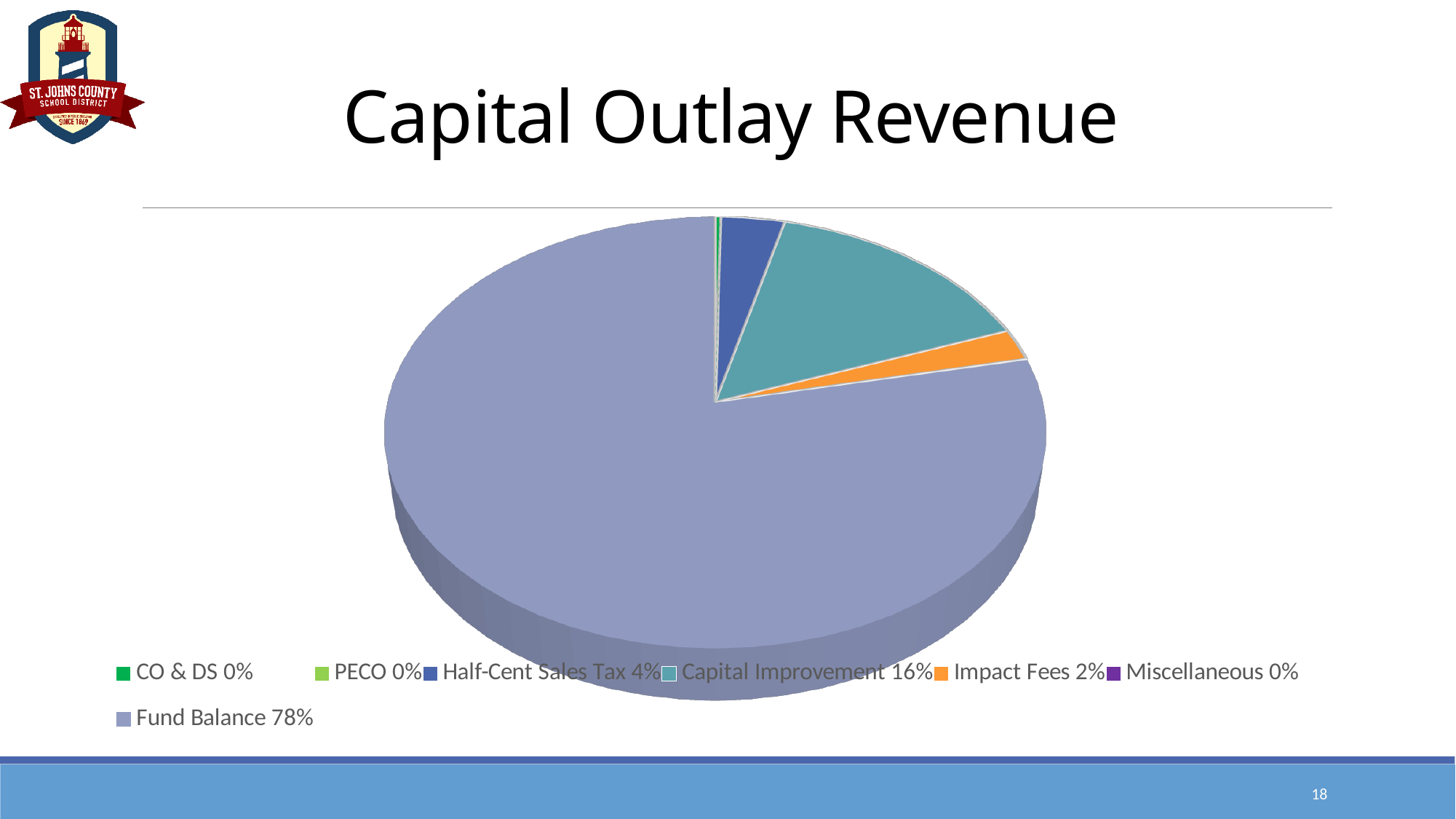
What is the difference in percentage points between Fund Balance and Capital Improvement? 62 What type of chart is shown on the slide? Pie chart What percentage is shown for PECO? 0% What percentage is shown for Impact Fees? 2% What share of Capital Outlay Revenue is Fund Balance? 78% How many categories does the legend list? 7 Which is larger, Half-Cent Sales Tax or Impact Fees? Half-Cent Sales Tax Which category has the largest share of the pie? Fund Balance What colour is the Impact Fees slice? Orange What is the title of the chart? Capital Outlay Revenue What percentage is shown for Capital Improvement? 16% What percentage is shown for Half-Cent Sales Tax? 4%